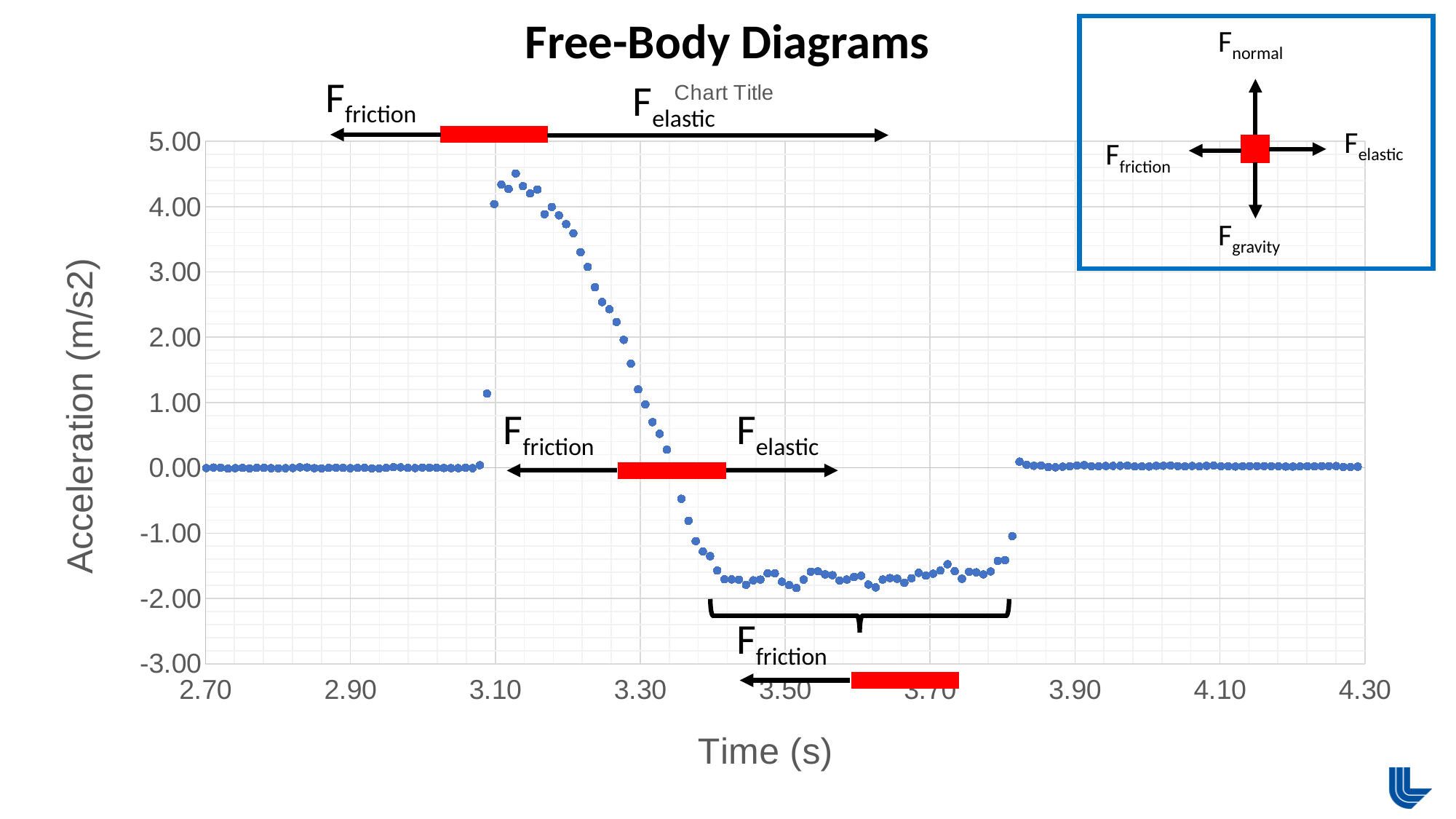
What is the label of the horizontal axis of the chart? Time (s) What is the label of the vertical axis of the chart? Acceleration (m/s2) Between time 3.10 and 3.40, do the plotted acceleration values rise or fall as time increases? fall Around which time does the acceleration reach its highest value: 3.10, 3.50 or 3.90? 3.10 Is the acceleration at time 4.10 greater or less than 1.00? less Is the lowest acceleration value plotted greater or less than -1.00? less Is the highest acceleration value plotted greater or less than 4.00? greater Which is larger, the acceleration at time 3.10 or the acceleration at time 3.50? 3.10 What kind of chart is shown on the slide? scatter chart